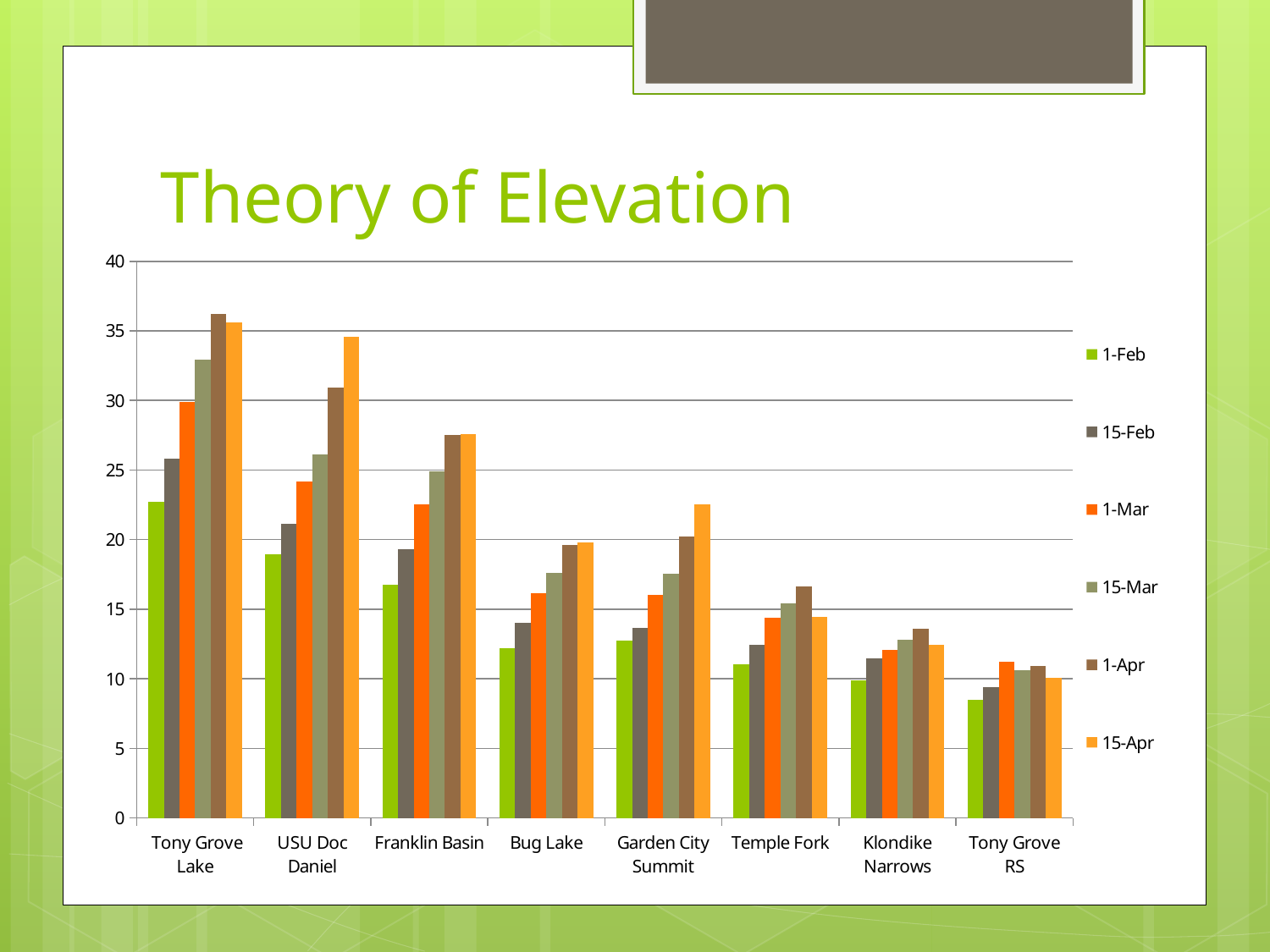
Which category has the highest 1-Feb value? Tony Grove Lake How many series does the legend list? 6 Which category has the lowest 1-Feb value? Tony Grove RS Is the 15-Apr value for USU Doc Daniel greater or less than 30? greater What kind of chart is shown on the slide? bar chart How many categories are shown along the x axis? 8 Is the 15-Apr value for Garden City Summit greater or less than 20? greater Is the 1-Feb value for Tony Grove RS greater or less than 10? less What is the title of the chart on the slide? Theory of Elevation Which is larger, the 15-Apr value for Garden City Summit or the 15-Apr value for Temple Fork? Garden City Summit Do the 1-Feb values generally rise or fall from left to right along the x axis? fall